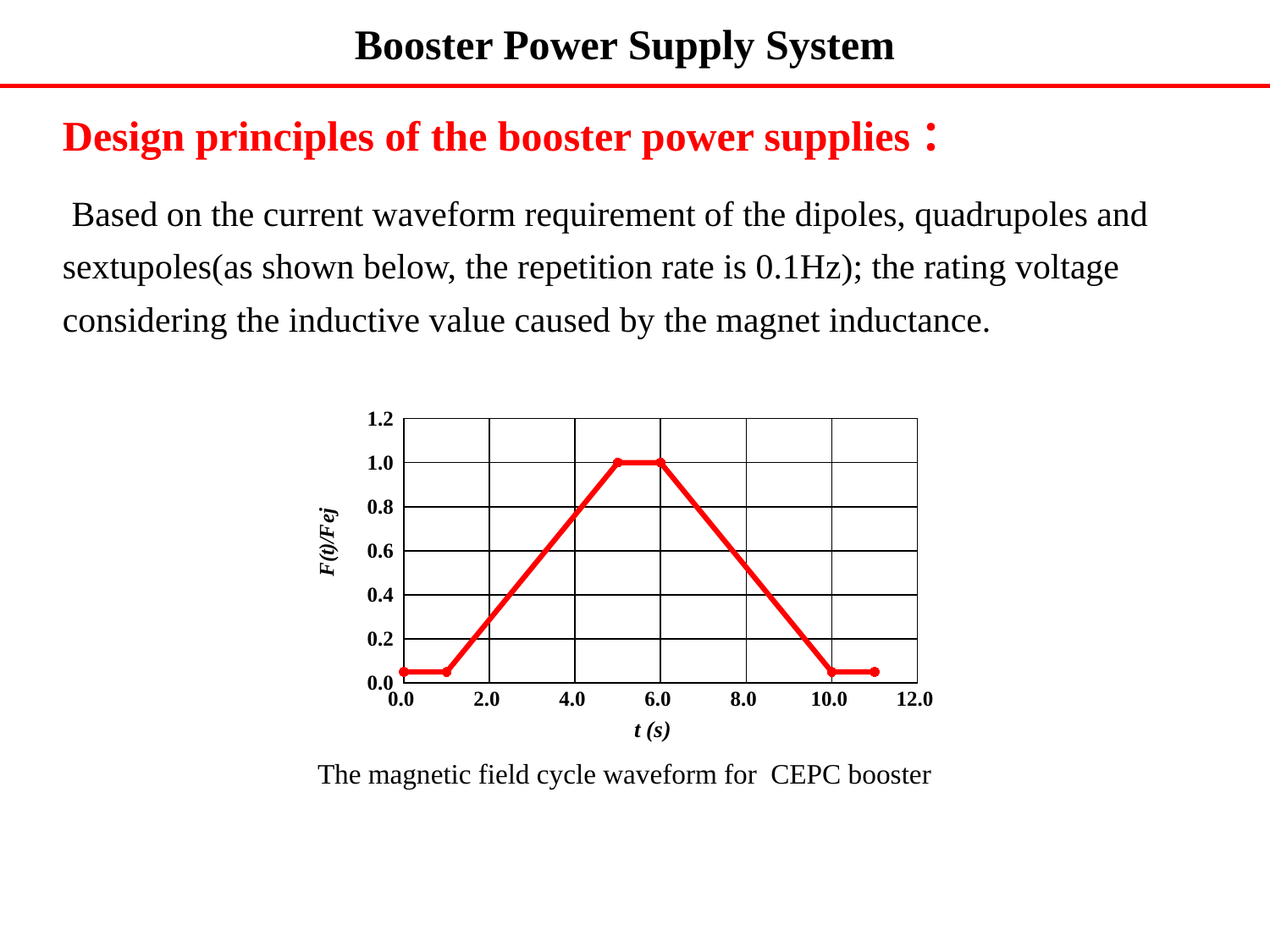
Does the waveform rise or fall between t = 1.0 s and t = 5.0 s? rise How many data points are marked on the waveform? 6 Does the waveform rise or fall between t = 6.0 s and t = 10.0 s? fall What is the label of the x axis of the chart? t (s) Is the value of F(t)/Fej at t = 10.0 s greater or less than 0.2? less Is the value of F(t)/Fej at t = 2.0 s greater or less than 0.2? greater What kind of chart is shown on the slide? line chart What is the maximum value of F(t)/Fej reached by the waveform? 1.0 Is the value of F(t)/Fej at t = 1.0 s greater or less than 0.2? less What is the value of F(t)/Fej at t = 6.0 s? 1.0 What is the value of F(t)/Fej at t = 5.0 s? 1.0 Which is larger, the value of F(t)/Fej at t = 5.0 s or at t = 10.0 s? t = 5.0 s